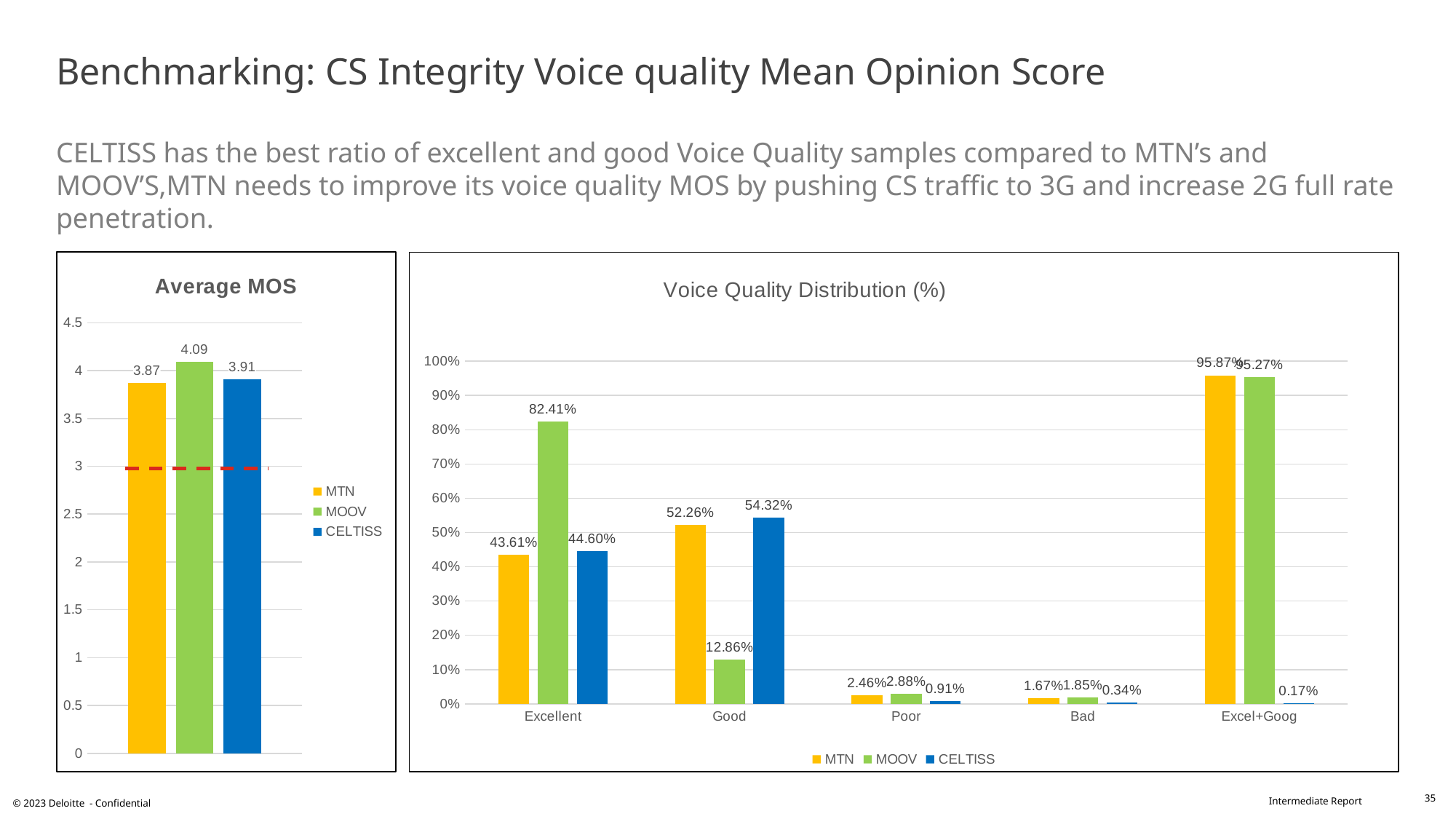
In the Average MOS chart, which operator has the lowest average MOS? MTN In the Average MOS chart, how many series does the legend list? 3 In the Voice Quality Distribution (%) chart, which is larger for Poor: MTN or CELTISS? MTN What kind of chart is the Voice Quality Distribution (%) chart? Bar chart In the Voice Quality Distribution (%) chart, what is MOOV's value for Excellent? 82.41% In the Voice Quality Distribution (%) chart, which operator has the highest value for Excellent? MOOV In the Voice Quality Distribution (%) chart, which operator has the lowest value for Good? MOOV In the Voice Quality Distribution (%) chart, what is CELTISS's value for Good? 54.32% In the Average MOS chart, what is the value for MOOV? 4.09 In the Average MOS chart, what is the difference between MOOV's and MTN's values? 0.22 In the Voice Quality Distribution (%) chart, what is the difference between CELTISS's and MTN's values for Excellent? 0.99% In the Voice Quality Distribution (%) chart, how many categories are shown on the x axis? 5